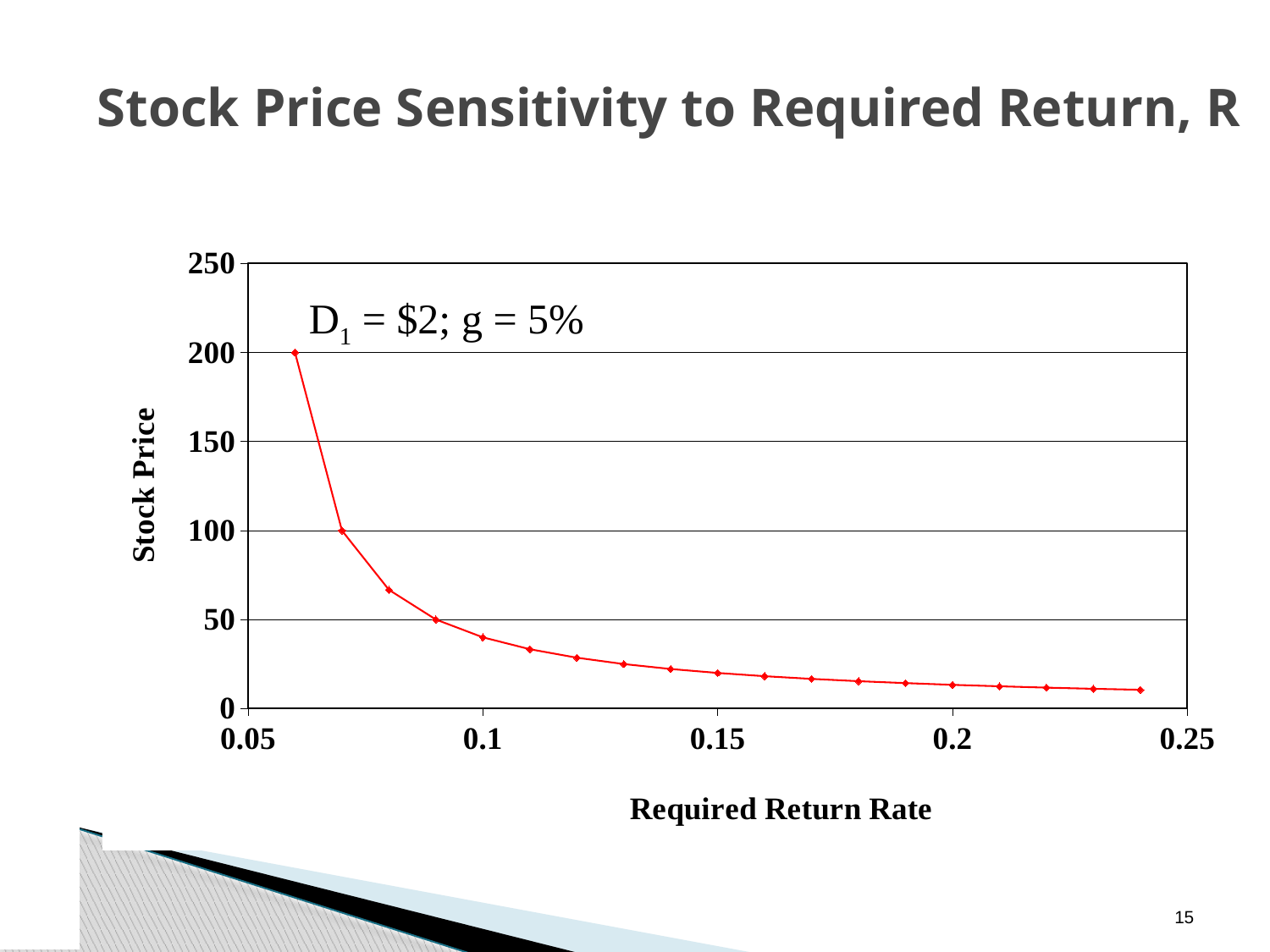
What is the title of the x axis? Required Return Rate Is the stock price at a required return rate of 0.15 greater or less than 50? less Does the stock price rise or fall as the required return rate increases along the x axis? fall What kind of chart is shown on the slide? line chart Is the stock price at a required return rate of 0.1 greater or less than 50? less What assumption is written inside the chart area? D1 = $2; g = 5% Is the stock price at the leftmost point greater or less than 150? greater Which is larger, the stock price at a required return rate of 0.1 or at 0.2? 0.1 What is the stock price at the leftmost point of the line? 200 At which end of the x axis is the stock price highest, the lowest required return rate or the highest? the lowest required return rate